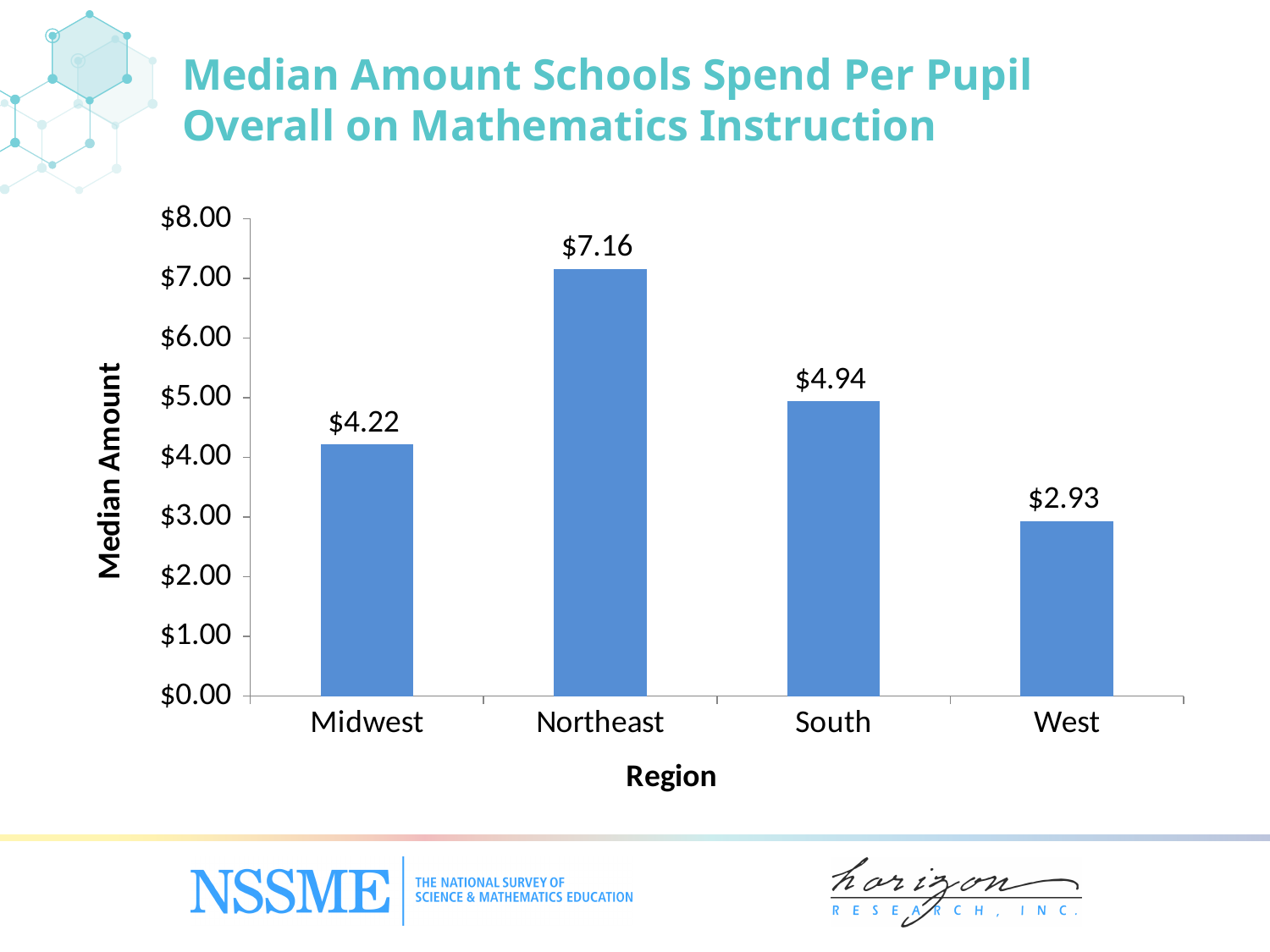
Which region has the highest median amount spent per pupil? Northeast What kind of chart is shown on the slide? Bar chart What is the median amount spent per pupil on mathematics instruction in the Northeast? $7.16 How many regions are shown on the chart? 4 Which region has a larger median amount, the South or the Midwest? South What is the label of the vertical axis? Median Amount Which region has the lowest median amount spent per pupil? West What is the difference between the median amounts for the Northeast and the South? $2.22 Is the median amount for the South greater or less than $5.00? less What is the median amount spent per pupil in the Midwest? $4.22 What is the difference between the median amounts for the Midwest and the West? $1.29 What is the median amount spent per pupil in the West? $2.93